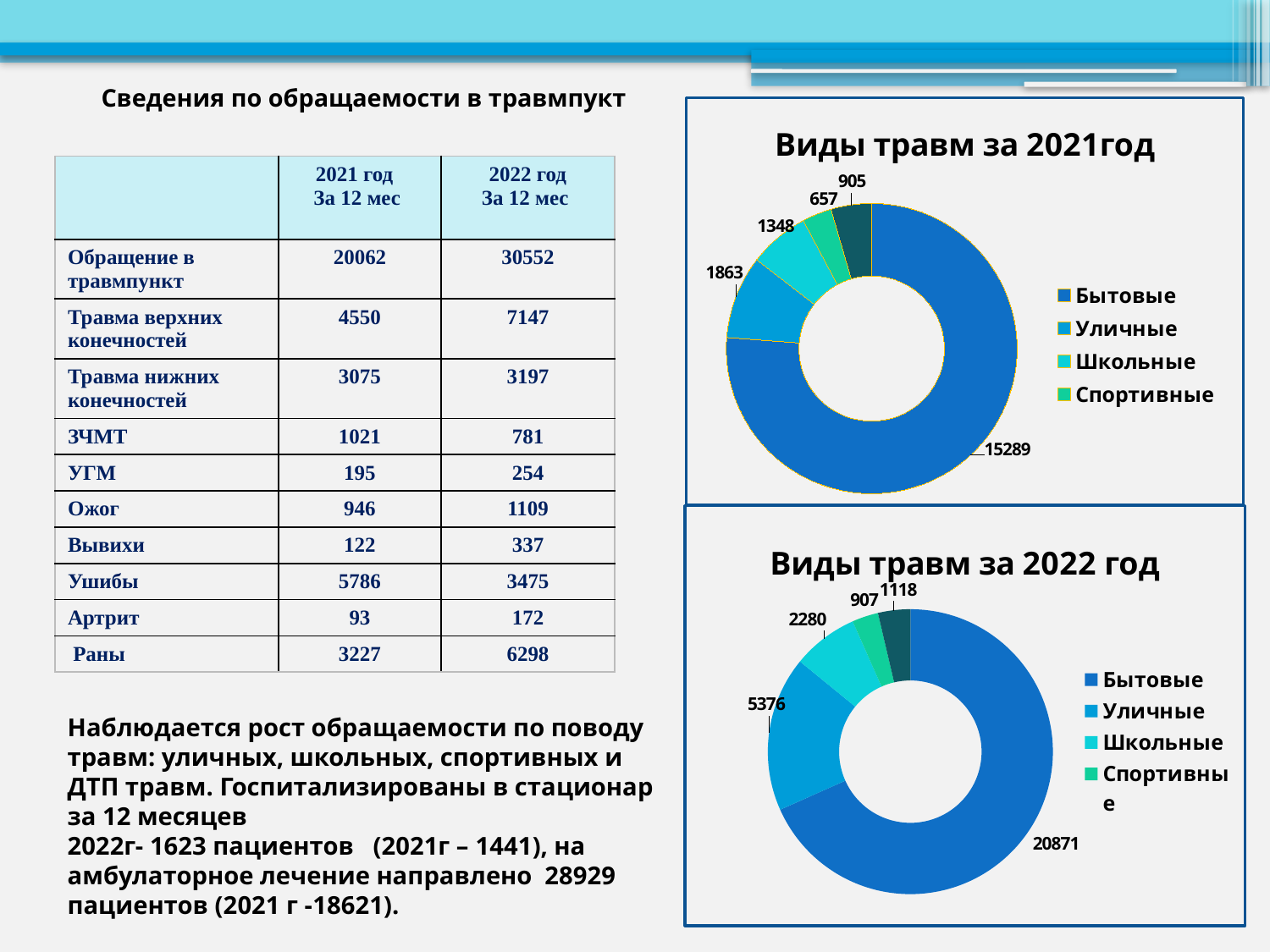
What kind of chart is 'Виды травм за 2022 год'? Doughnut (pie) chart How many slices does the chart 'Виды травм за 2022 год' have? 5 In the chart 'Виды травм за 2021год', what is the value for Бытовые? 15289 In the chart 'Виды травм за 2022 год', which category has the largest value? Бытовые In the chart 'Виды травм за 2021год', what is the difference between the values for Бытовые and Уличные? 13426 In the chart 'Виды травм за 2021год', what is the value for Уличные? 1863 In the chart 'Виды травм за 2022 год', what is the value for Школьные? 2280 In the chart 'Виды травм за 2021год', which is larger: Школьные or Спортивные? Школьные In the chart 'Виды травм за 2022 год', what is the difference between the values for Уличные and Школьные? 3096 How many entries does the legend of the chart 'Виды травм за 2021год' list? 4 In the chart 'Виды травм за 2022 год', what is the value for Уличные? 5376 In the chart 'Виды травм за 2021год', which legend category has the smallest value? Спортивные